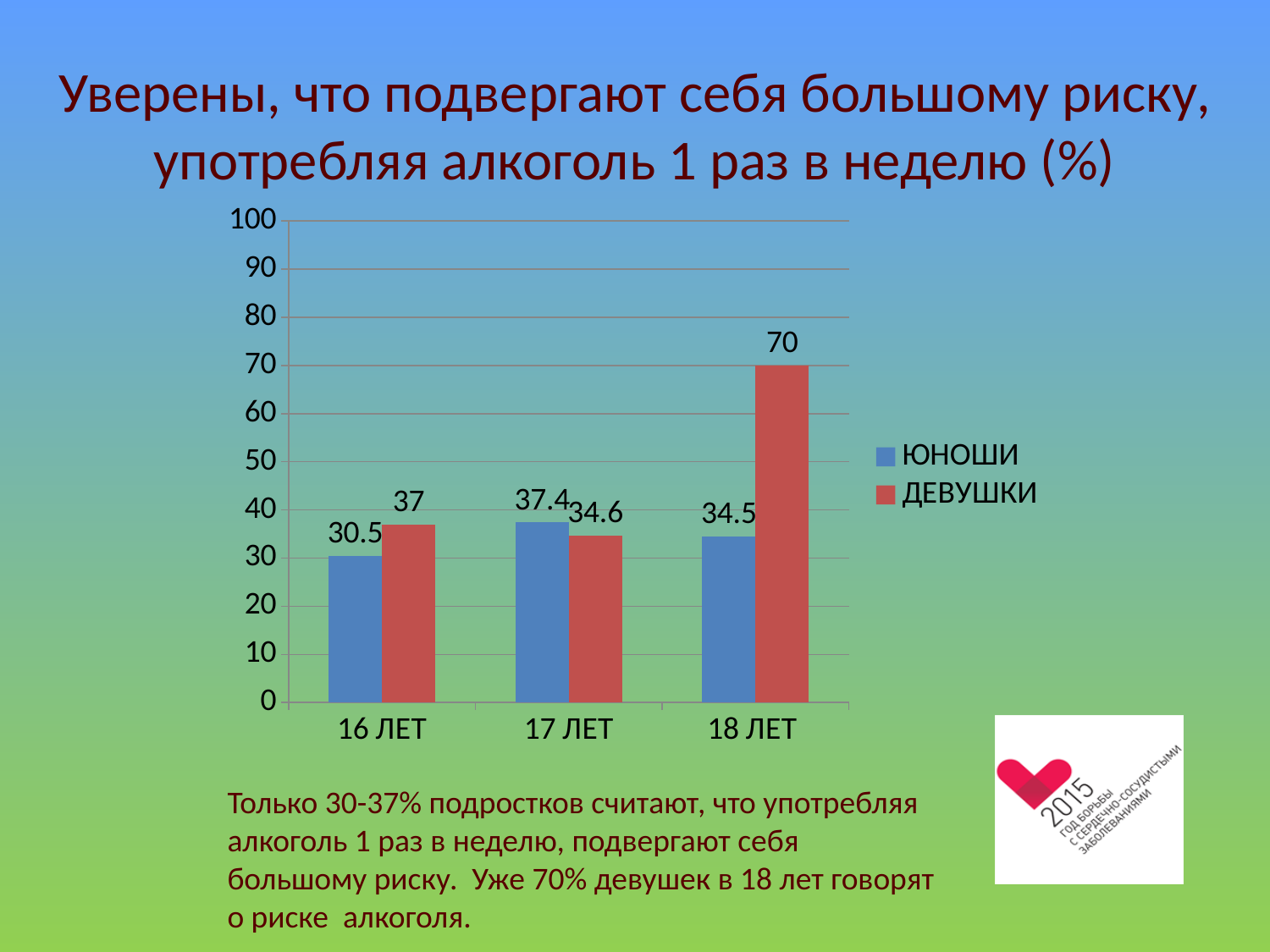
How many age categories are shown on the x axis? 3 Which is larger at 17 ЛЕТ: ЮНОШИ or ДЕВУШКИ? ЮНОШИ What is the value for ДЕВУШКИ at 18 ЛЕТ? 70 What kind of chart is shown on the slide? bar chart Which age group has the highest value for ДЕВУШКИ? 18 ЛЕТ Which colour represents ДЕВУШКИ in the chart? red How many series does the legend list? 2 What is the value for ЮНОШИ at 17 ЛЕТ? 37.4 What is the value for ДЕВУШКИ at 16 ЛЕТ? 37 Which age group has the lowest value for ЮНОШИ? 16 ЛЕТ What is the difference between ДЕВУШКИ and ЮНОШИ at 18 ЛЕТ? 35.5 What is the value for ЮНОШИ at 16 ЛЕТ? 30.5